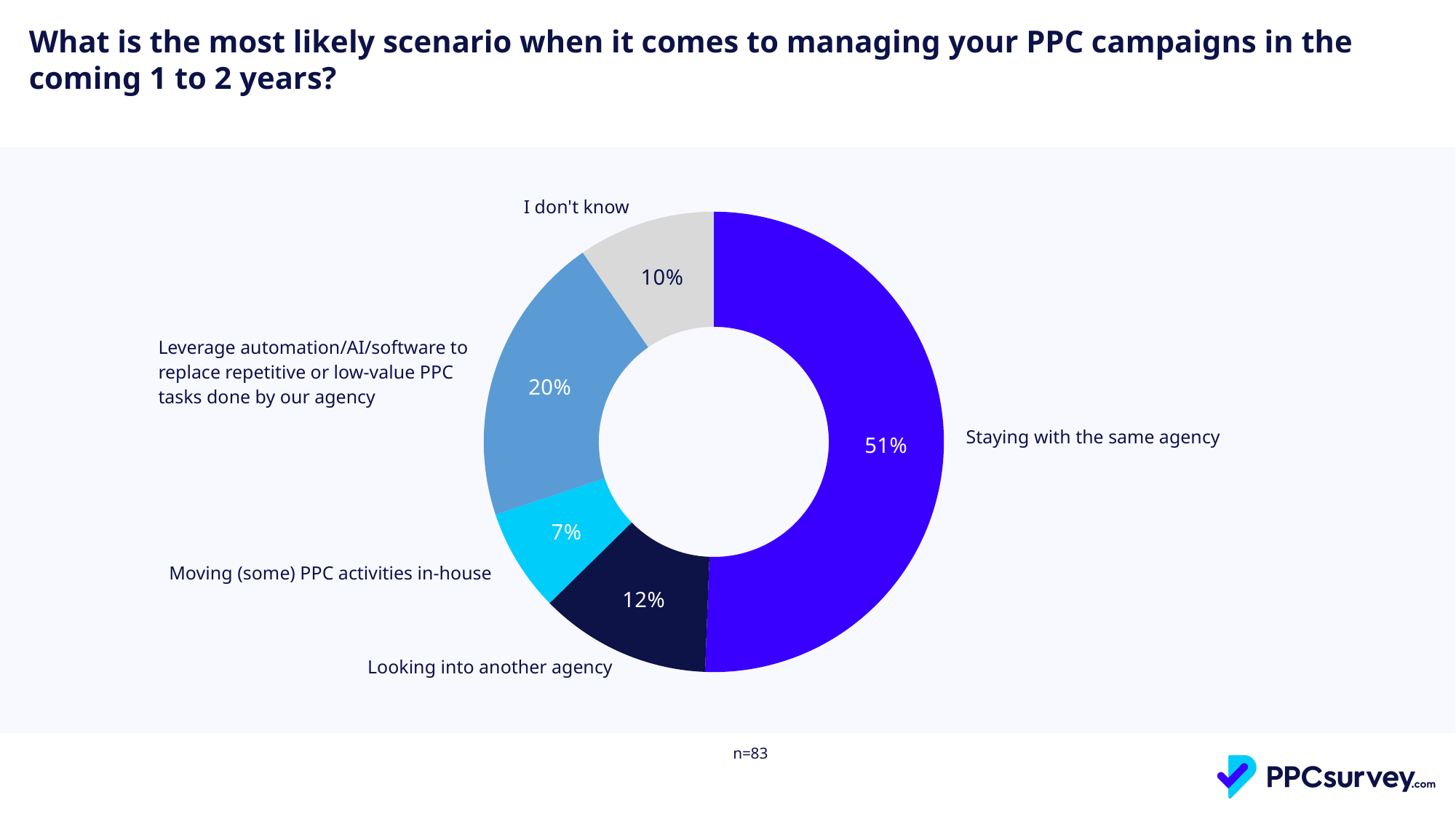
How many percentage points higher is 'Staying with the same agency' than 'Leverage automation/AI/software to replace repetitive or low-value PPC tasks done by our agency'? 31 percentage points Which is larger: the share for 'Looking into another agency' or the share for 'I don't know'? Looking into another agency What percentage of respondents answered 'I don't know'? 10% What percentage of respondents are looking into another agency? 12% What percentage of respondents expect to be staying with the same agency? 51% Which scenario has the largest share of respondents? Staying with the same agency Which scenario has the smallest share of respondents? Moving (some) PPC activities in-house What is the sample size (n) shown below the chart? n=83 How many scenario categories are shown in the chart? 5 What percentage of respondents expect to move (some) PPC activities in-house? 7% What type of chart is shown on the slide? Donut (pie) chart What share of respondents plan to leverage automation/AI/software to replace repetitive or low-value PPC tasks done by their agency? 20%